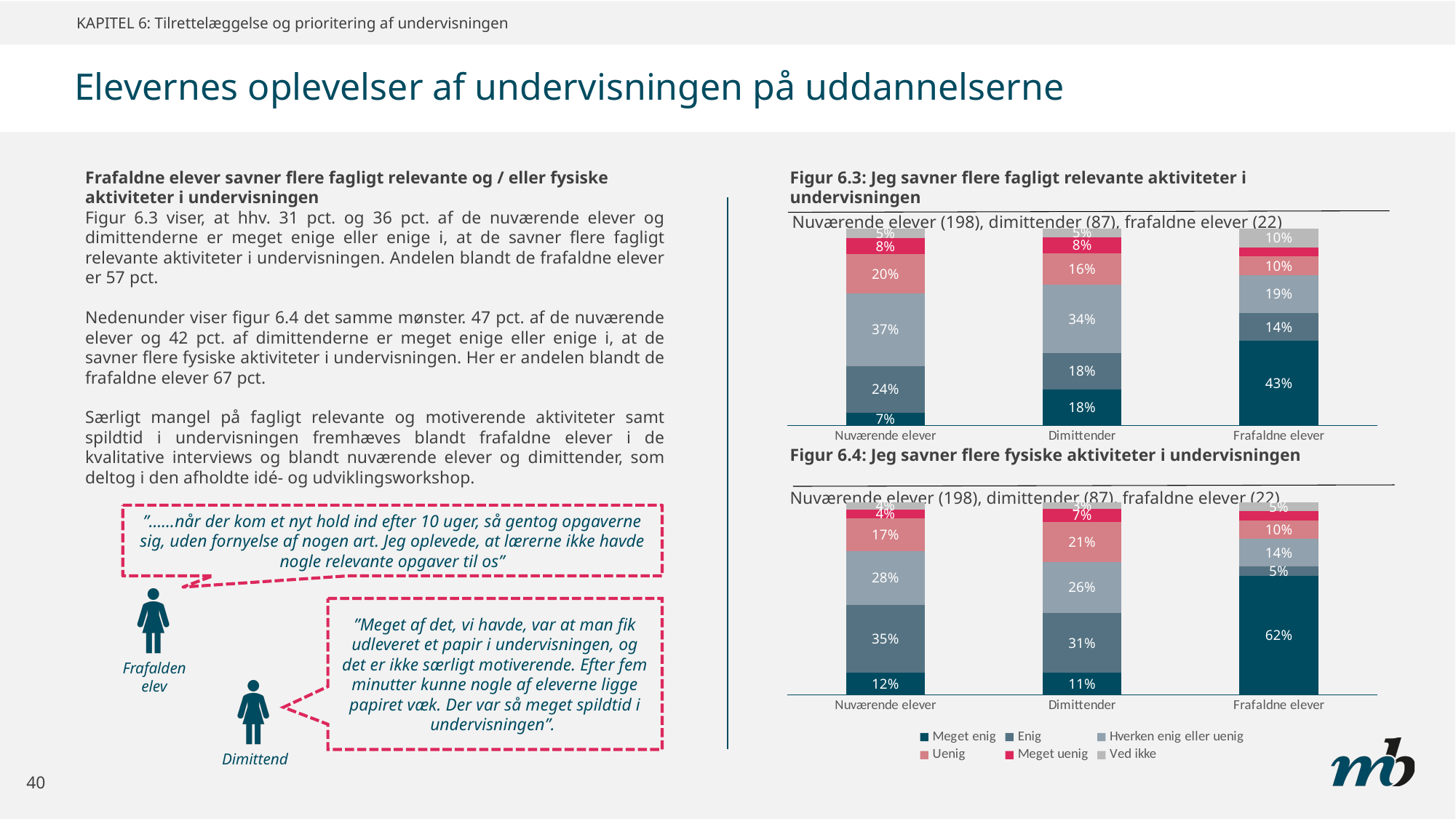
In Figur 6.3, what percentage of Frafaldne elever answered Meget enig? 43% In Figur 6.3, which is larger: the Uenig share for Nuværende elever or for Dimittender? Nuværende elever In Figur 6.4, which group has the lowest Meget enig share? Dimittender What type of chart is Figur 6.4? Stacked bar chart In Figur 6.4, what percentage of Frafaldne elever answered Meget enig? 62% How many series does the legend list for the charts on the slide? 6 In Figur 6.4, what is the difference between the Uenig shares of Dimittender and Nuværende elever? 4 percentage points In Figur 6.3, which group has the highest Meget enig share? Frafaldne elever How many groups are shown on the x axis of Figur 6.3? 3 In Figur 6.3, what is the difference between the Meget enig shares of Dimittender and Nuværende elever? 11 percentage points In Figur 6.3, what is the Hverken enig eller uenig share for Nuværende elever? 37% In Figur 6.4, what is the Enig share for Dimittender? 31%